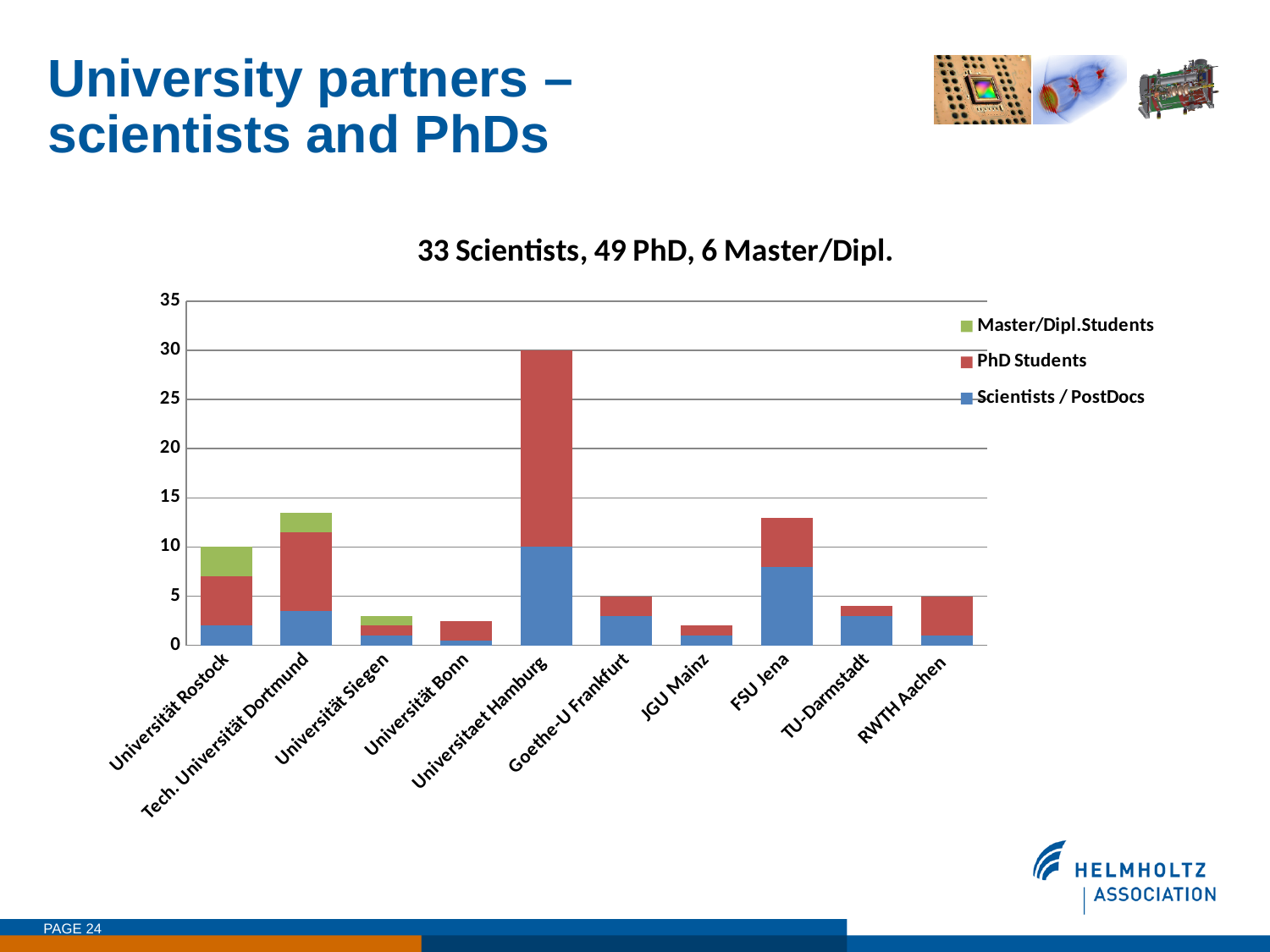
How many series does the chart legend list? 3 What kind of chart is shown on the slide? Stacked bar chart Which university has the tallest bar in the chart? Universitaet Hamburg What is the title of the chart? 33 Scientists, 49 PhD, 6 Master/Dipl. What is the total height of the bar for Universitaet Hamburg? 30 Is the total value for Tech. Universität Dortmund greater or less than 10? greater Which has a taller bar, Universitaet Hamburg or FSU Jena? Universitaet Hamburg What is the total height of the bar for Universität Rostock? 10 Is the total value for FSU Jena greater or less than 10? greater How many universities are shown on the x axis of the chart? 10 Which series is shown in green in the chart legend? Master/Dipl.Students Is the total value for Universität Siegen greater or less than 5? less